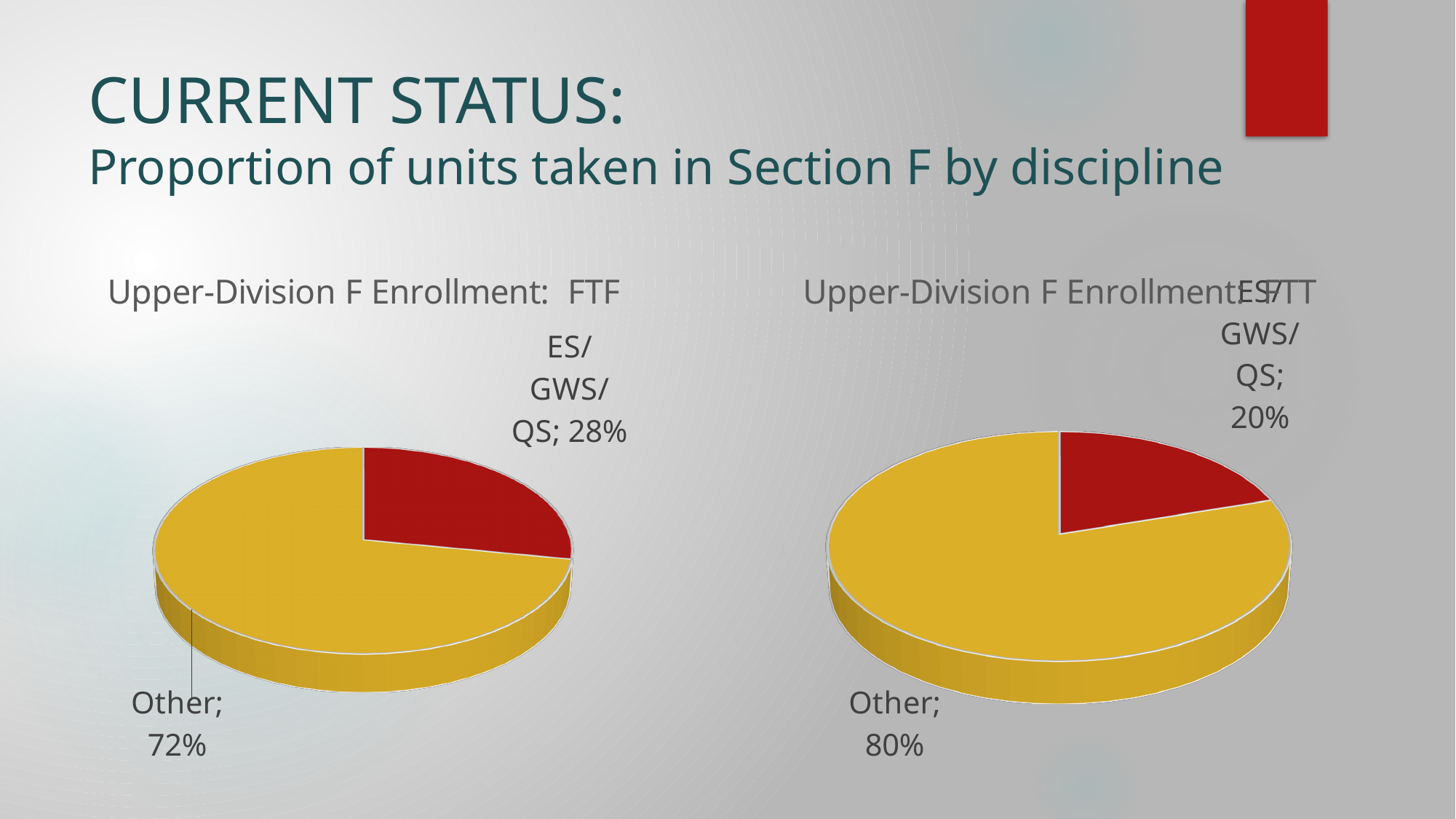
In the right pie chart, what share is labelled for ES/GWS/QS? 20% In the right pie chart, what share is labelled for Other? 80% In the left pie chart (Upper-Division F Enrollment: FTF), which slice is the largest? Other How many slices does the left pie chart (Upper-Division F Enrollment: FTF) have? 2 In the left pie chart (Upper-Division F Enrollment: FTF), what share is labelled for Other? 72% What type of chart is used on the left of the slide? pie chart Which chart shows a larger ES/GWS/QS share, the left pie chart or the right pie chart? the left pie chart In the left pie chart (Upper-Division F Enrollment: FTF), what is the difference between the Other share and the ES/GWS/QS share? 44% What colour is the ES/GWS/QS slice in the left pie chart? red In the right pie chart, what is the difference between the Other share and the ES/GWS/QS share? 60% In the right pie chart, which slice is the smallest? ES/GWS/QS